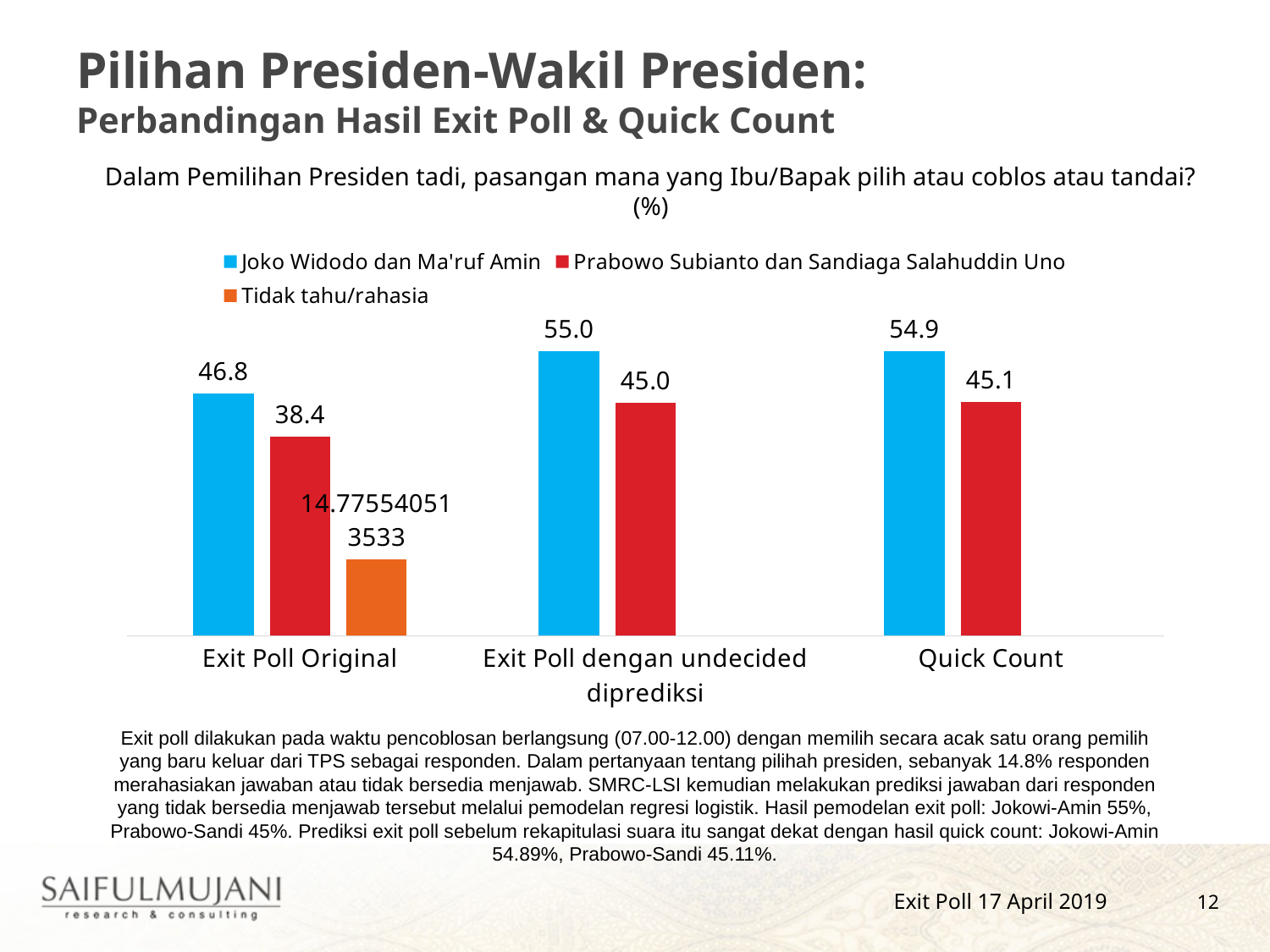
What is the value for Prabowo Subianto dan Sandiaga Salahuddin Uno in the Exit Poll Original category? 38.4 What is the value for Prabowo Subianto dan Sandiaga Salahuddin Uno in the Quick Count category? 45.1 In which category is the value for Prabowo Subianto dan Sandiaga Salahuddin Uno the lowest? Exit Poll Original What kind of chart is shown on the slide? bar chart What is the value for Joko Widodo dan Ma'ruf Amin in the Exit Poll Original category? 46.8 What colour represents the Tidak tahu/rahasia series in the chart? orange What is the value for Joko Widodo dan Ma'ruf Amin in the Exit Poll dengan undecided diprediksi category? 55.0 In the Quick Count category, which series has the larger value: Joko Widodo dan Ma'ruf Amin or Prabowo Subianto dan Sandiaga Salahuddin Uno? Joko Widodo dan Ma'ruf Amin How many categories are shown on the x axis of the chart? 3 What is the difference between the Joko Widodo dan Ma'ruf Amin and Prabowo Subianto dan Sandiaga Salahuddin Uno values in the Exit Poll Original category? 8.4 What is the difference between the Joko Widodo dan Ma'ruf Amin and Prabowo Subianto dan Sandiaga Salahuddin Uno values in the Quick Count category? 9.8 How many series does the chart legend list? 3